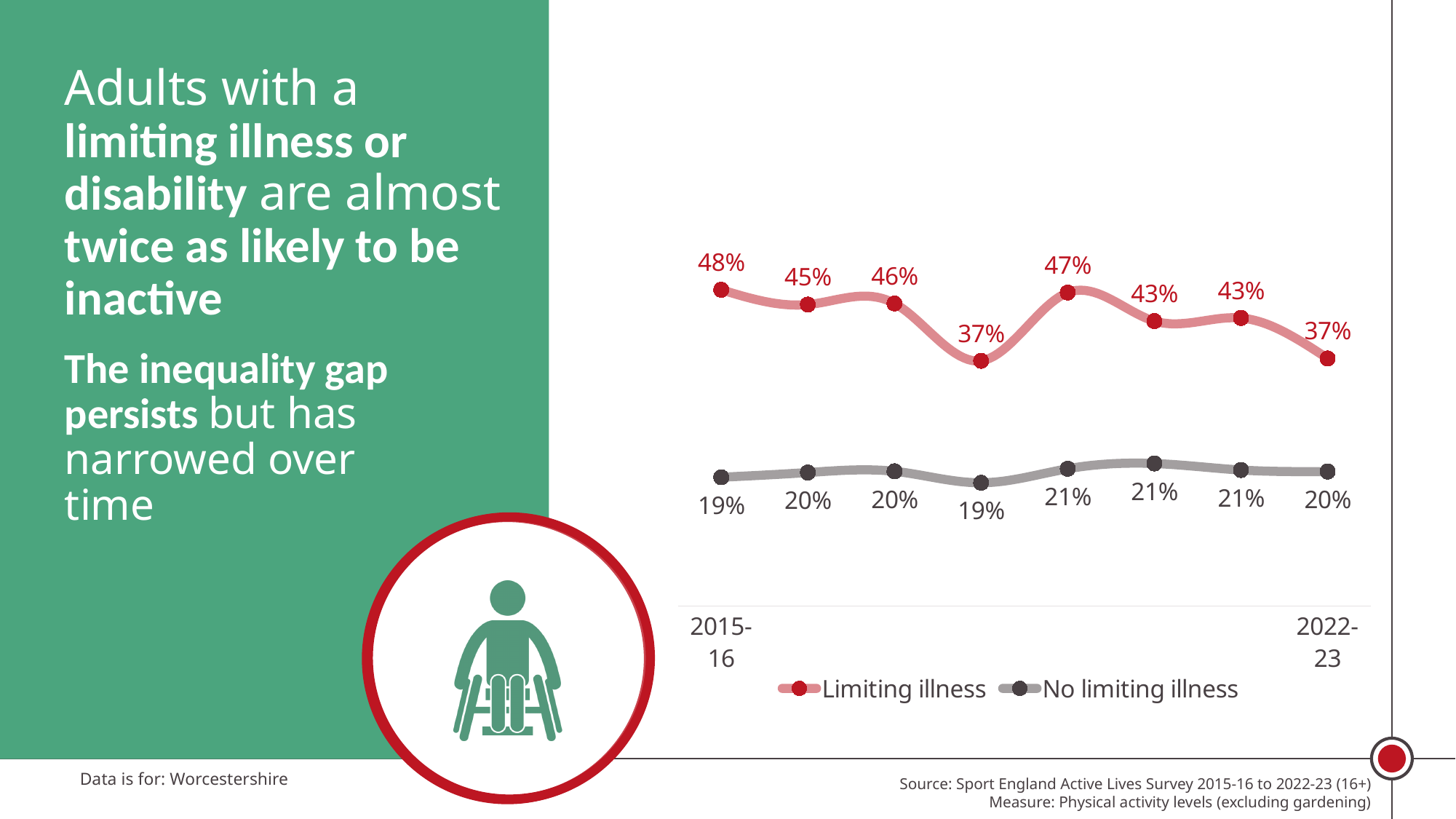
What type of chart is shown on the slide? line chart What is the value for No limiting illness in 2022-23? 20% What is the value for Limiting illness in 2022-23? 37% How many data points are plotted for each series? 8 What is the lowest value plotted for the No limiting illness series? 19% How many series does the legend list? 2 What is the value for No limiting illness in 2015-16? 19% What is the highest value plotted for the Limiting illness series? 48% What is the difference between the Limiting illness and No limiting illness values in 2022-23? 17% What is the value for Limiting illness in 2015-16? 48% Which series has the higher value in 2022-23, Limiting illness or No limiting illness? Limiting illness What is the difference between the Limiting illness and No limiting illness values in 2015-16? 29%